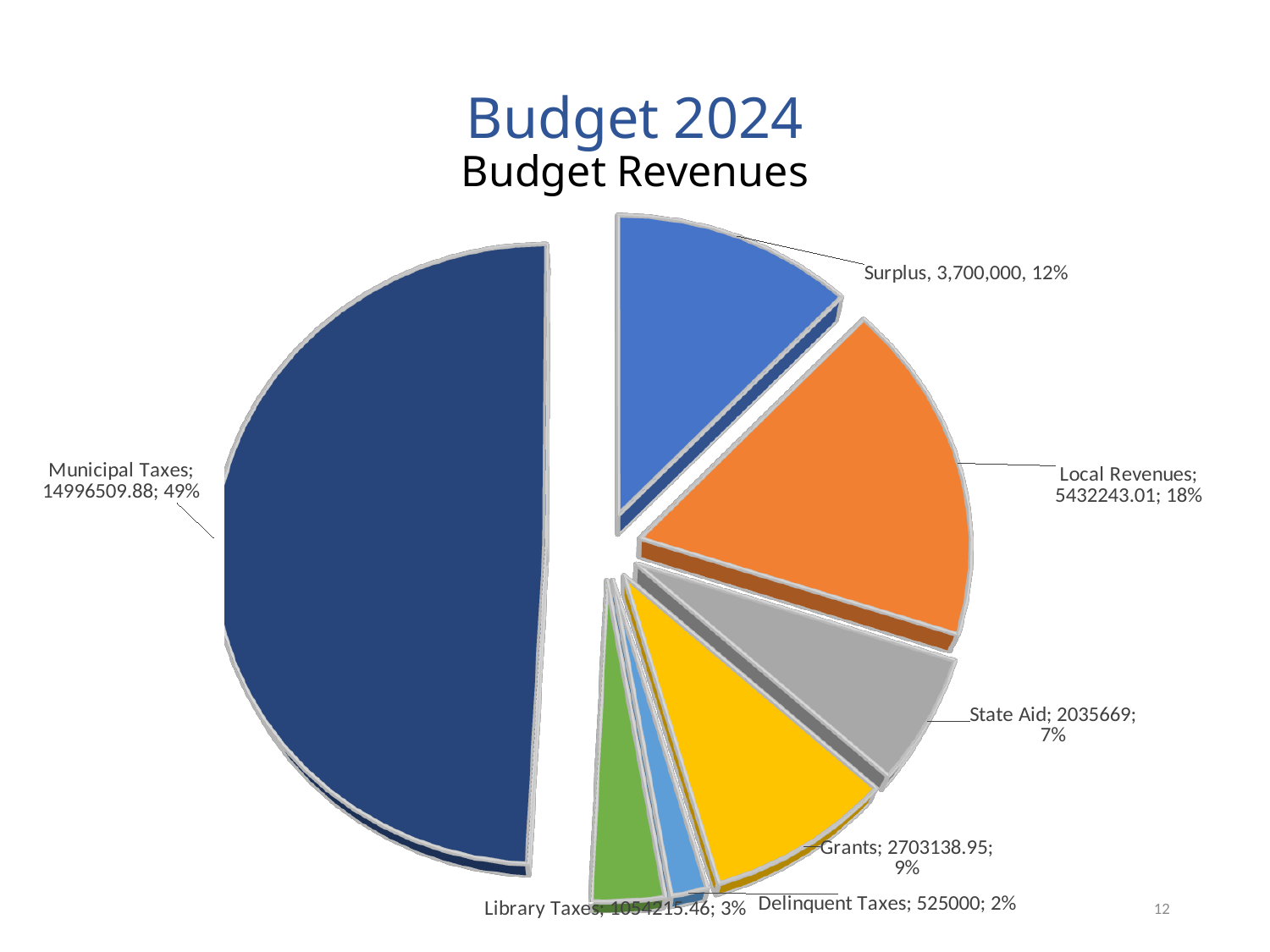
What kind of chart is shown on the slide? Pie chart What percentage share of the pie is State Aid? 7% Which category has the largest slice of the pie? Municipal Taxes What is the value shown for Local Revenues? 5432243.01 What is the value shown for Surplus? 3,700,000 What is the difference between the Delinquent Taxes value and the State Aid value? 1510669 What is the title of the chart? Budget Revenues Which category has the smallest slice of the pie? Delinquent Taxes What is the value shown for Municipal Taxes? 14996509.88 How many slices does the pie chart have? 7 Which is larger, Local Revenues or Surplus? Local Revenues What percentage share of the pie is Grants? 9%